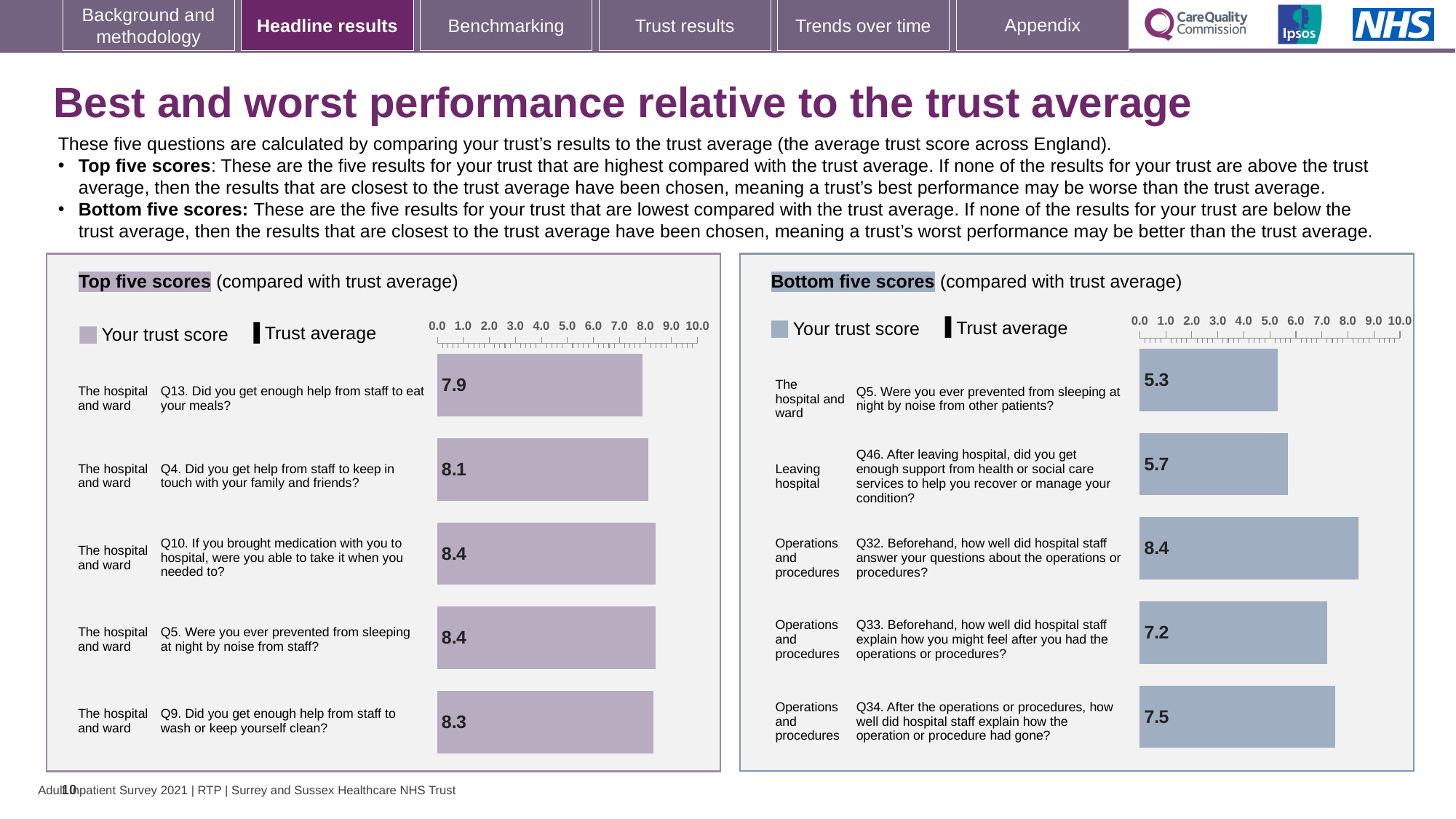
In the Bottom five scores chart, which question has the lowest trust score? Q5. Were you ever prevented from sleeping at night by noise from other patients? In the Top five scores chart, what is the trust score for Q9 (Did you get enough help from staff to wash or keep yourself clean?)? 8.3 In the Top five scores chart, what is the trust score for Q13 (Did you get enough help from staff to eat your meals?)? 7.9 How many series does the legend of the Top five scores chart list? 2 How many questions are shown in the Bottom five scores chart? 5 In the Bottom five scores chart, what is the trust score for Q33 (how well did hospital staff explain how you might feel after the operations or procedures)? 7.2 In the Top five scores chart, which question has the lowest trust score? Q13. Did you get enough help from staff to eat your meals? In the Bottom five scores chart, what is the trust score for Q46 (After leaving hospital, did you get enough support from health or social care services)? 5.7 In the Top five scores chart, which has the larger score: Q4 or Q13? Q4 What type of chart is used for the Top five scores? Bar chart In the Bottom five scores chart, which question has the highest trust score? Q32. Beforehand, how well did hospital staff answer your questions about the operations or procedures? In the Bottom five scores chart, what is the difference between the scores for Q32 (8.4) and Q5 (5.3)? 3.1